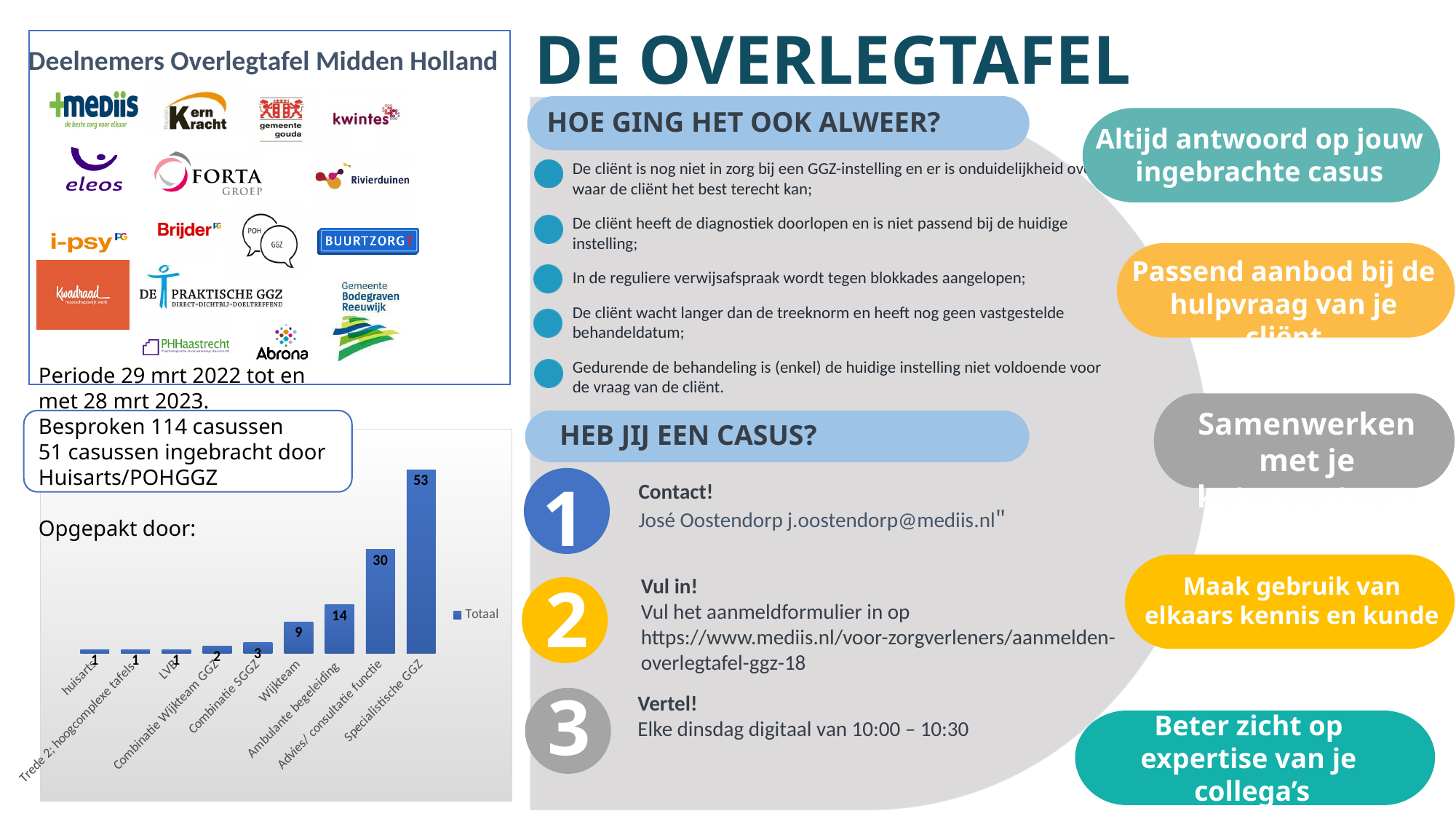
Which is larger in the bar chart: Wijkteam or Ambulante begeleiding? Ambulante begeleiding How many series does the legend of the bar chart list? 1 Which category has the highest value in the bar chart? Specialistische GGZ What is the legend entry of the bar chart? Totaal What is the value for Specialistische GGZ in the bar chart? 53 What is the value for Combinatie SGGZ in the bar chart? 3 What is the value for Wijkteam in the bar chart? 9 What is the difference between the values for Specialistische GGZ and Advies/ consultatie functie? 23 How many categories are shown in the bar chart? 9 What kind of chart is shown on the slide? bar chart What is the value for Ambulante begeleiding in the bar chart? 14 What is the value for Advies/ consultatie functie in the bar chart? 30